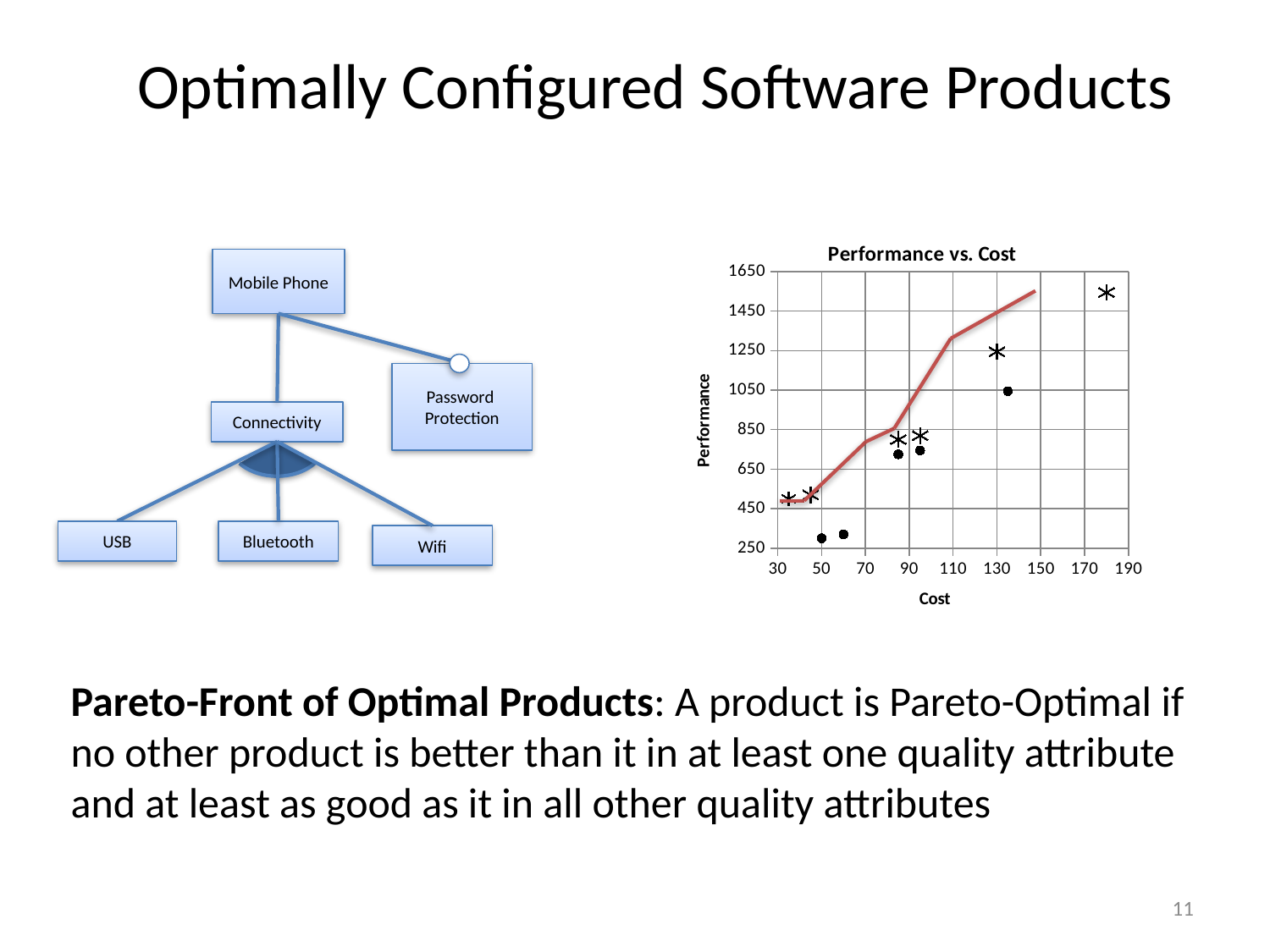
In the 'Performance vs. Cost' chart, is the performance of the dot point near cost 135 greater or less than 850? greater What is the label of the vertical axis in the 'Performance vs. Cost' chart? Performance In the 'Performance vs. Cost' chart, does performance along the red line rise or fall as cost increases? rise What is the highest tick value shown on the vertical axis of the 'Performance vs. Cost' chart? 1650 In the 'Performance vs. Cost' chart, which has the higher performance: the asterisk point near cost 130 or the dot point near cost 135? the asterisk point near cost 130 What is the lowest tick value shown on the horizontal axis of the 'Performance vs. Cost' chart? 30 In the 'Performance vs. Cost' chart, is the performance of the two dot points near cost 50-60 greater or less than 450? less In the 'Performance vs. Cost' chart, is the performance of the asterisk point at the far right (cost near 180) greater or less than 1450? greater What kind of chart is the 'Performance vs. Cost' chart? scatter chart